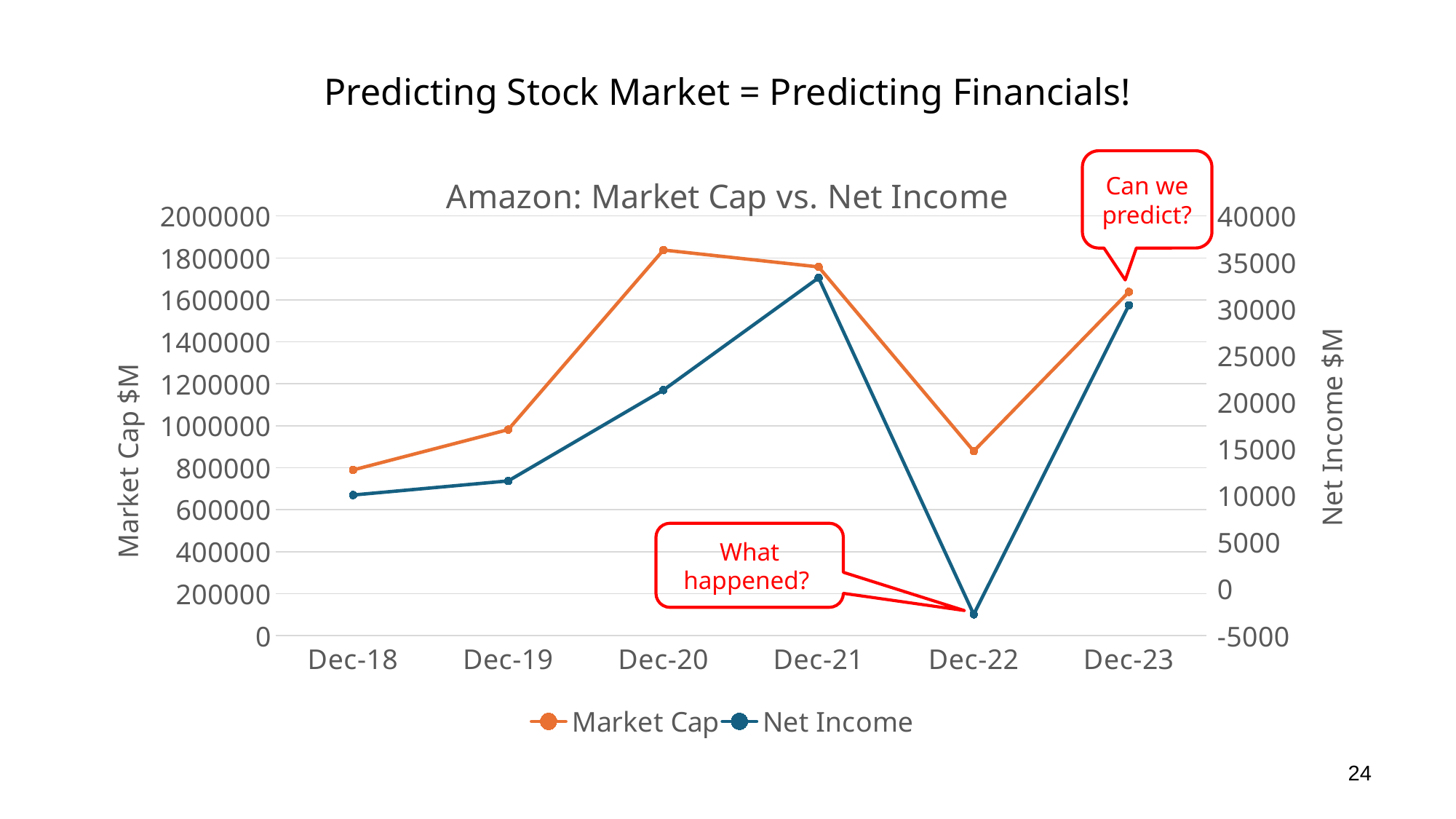
What kind of chart is shown on the slide? line chart What is the title of the chart? Amazon: Market Cap vs. Net Income Is the Net Income value for Dec-21 greater or less than 30000? greater Is the Net Income value for Dec-22 greater or less than 0? less How many time points are plotted along the x axis? 6 At which date is Net Income highest? Dec-21 Which is larger, Market Cap at Dec-20 or Market Cap at Dec-22? Dec-20 At which date is Market Cap highest? Dec-20 Is the Market Cap value for Dec-22 greater or less than 1000000? less At which date is Net Income lowest? Dec-22 How many series does the legend list? 2 Does Market Cap rise or fall from Dec-18 to Dec-20? rise